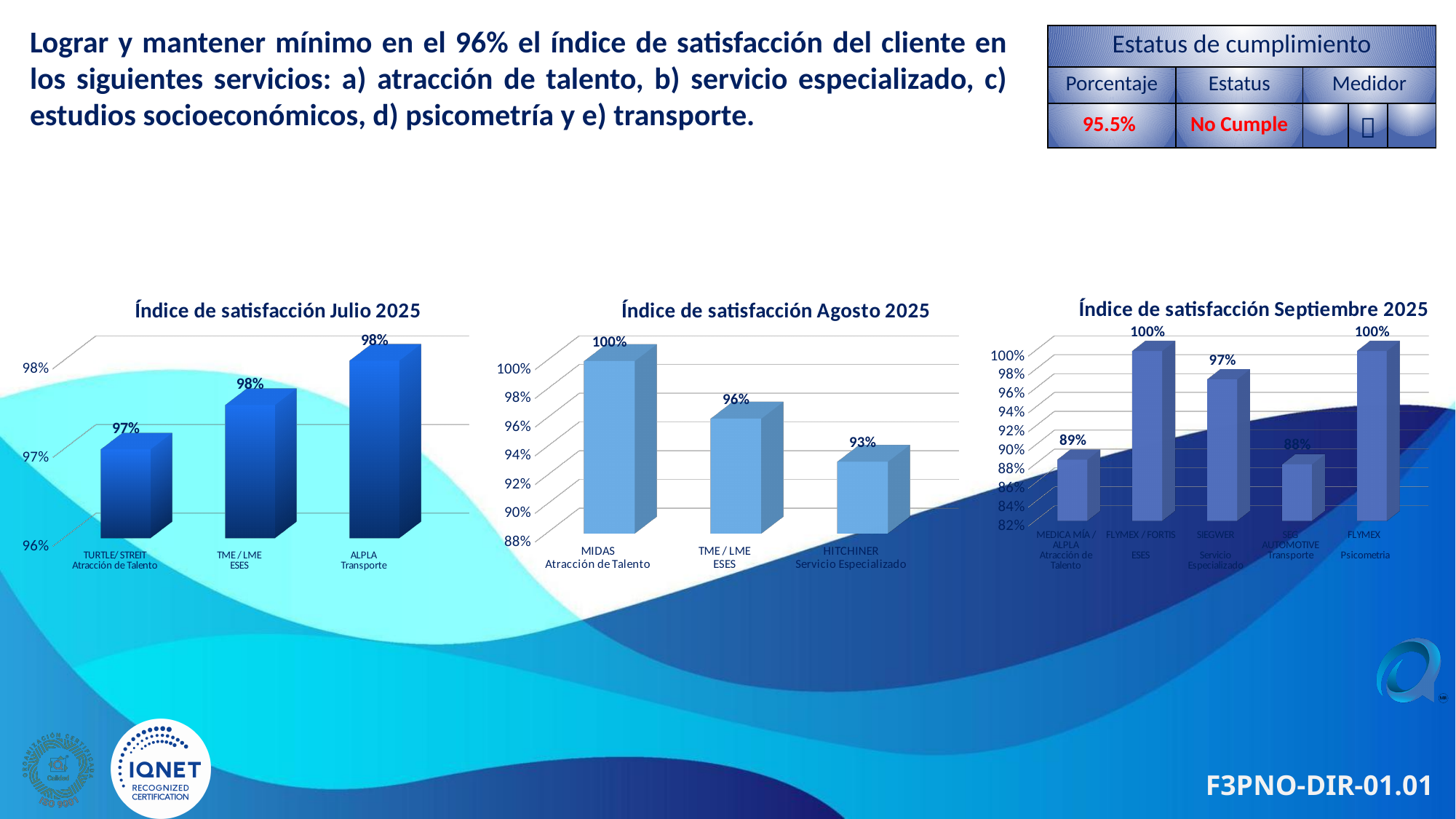
What kind of chart is 'Índice de satisfacción Agosto 2025'? bar chart In the 'Índice de satisfacción Septiembre 2025' chart, what is the value for SIEGWER (Servicio Especializado)? 97% In the 'Índice de satisfacción Agosto 2025' chart, what is the value for HITCHINER (Servicio Especializado)? 93% In the 'Índice de satisfacción Julio 2025' chart, how many bars are plotted? 3 In the 'Índice de satisfacción Septiembre 2025' chart, how many categories are plotted? 5 In the 'Índice de satisfacción Septiembre 2025' chart, which is larger: the value for MEDICA MÍA / ALPLA or the value for SIEGWER? SIEGWER In the 'Índice de satisfacción Septiembre 2025' chart, which category has the lowest value? SEG AUTOMOTIVE (Transporte) In the 'Índice de satisfacción Julio 2025' chart, what is the value for TURTLE/STREIT (Atracción de Talento)? 97% In the 'Índice de satisfacción Agosto 2025' chart, which category has the highest value? MIDAS (Atracción de Talento) In the 'Índice de satisfacción Agosto 2025' chart, do the values rise or fall from left to right? fall In the 'Índice de satisfacción Agosto 2025' chart, what is the difference between the MIDAS value and the HITCHINER value? 7% In the 'Índice de satisfacción Julio 2025' chart, which category has the lowest value? TURTLE/STREIT (Atracción de Talento)